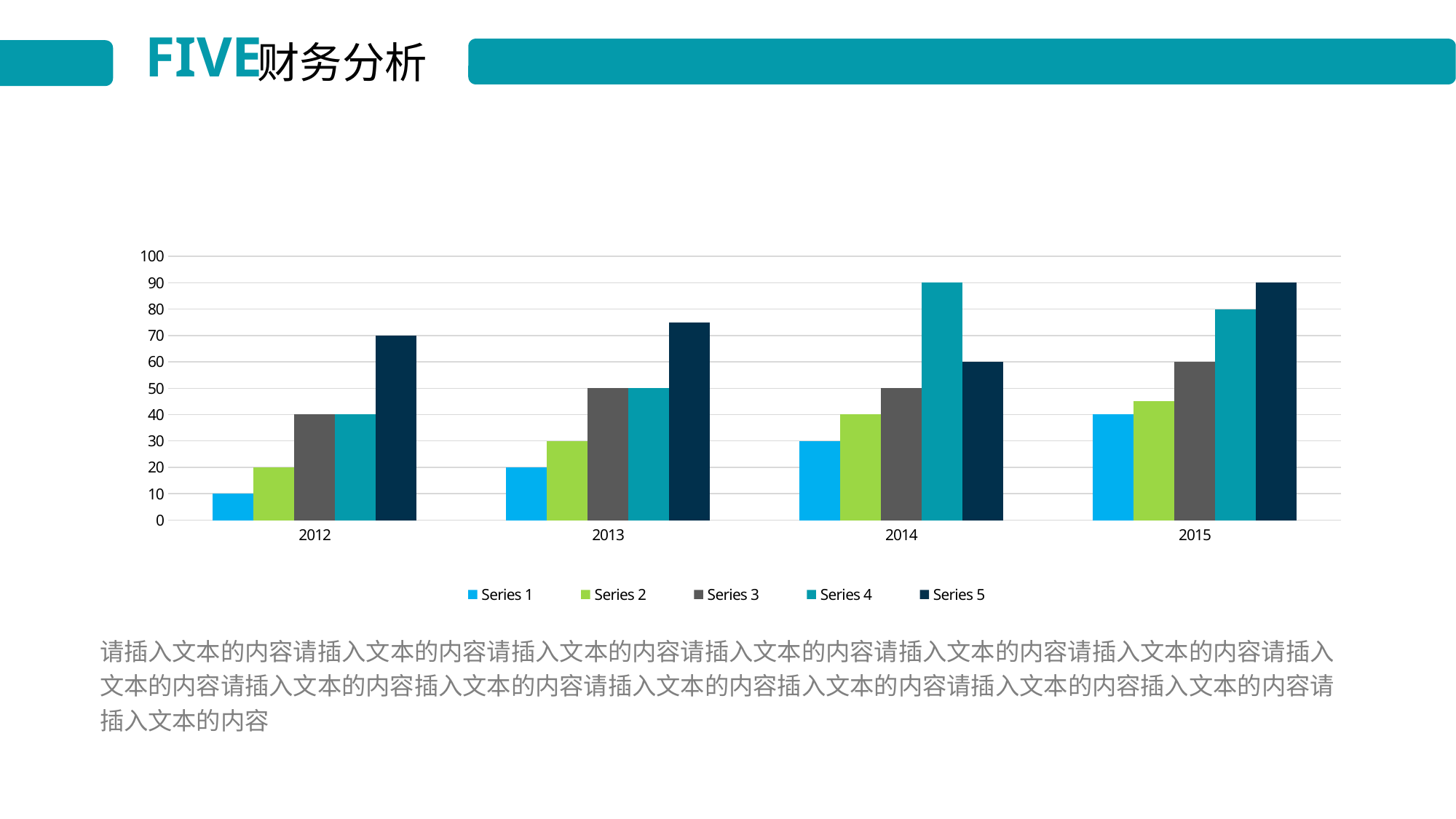
How many categories are shown on the x axis? 4 Is the value for Series 5 in 2013 greater or less than 70? greater What is the difference between Series 5 and Series 1 for 2012? 60 How many series does the legend list? 5 Which year has the highest value for Series 1? 2015 What is the value of Series 5 for 2015? 90 What is the value of Series 1 for 2012? 10 Which year has the lowest value for Series 3? 2012 What is the value of Series 4 for 2014? 90 What kind of chart is shown on the slide? bar chart Do the values for Series 1 rise or fall from 2012 to 2015? rise Which is larger for 2014, Series 4 or Series 5? Series 4